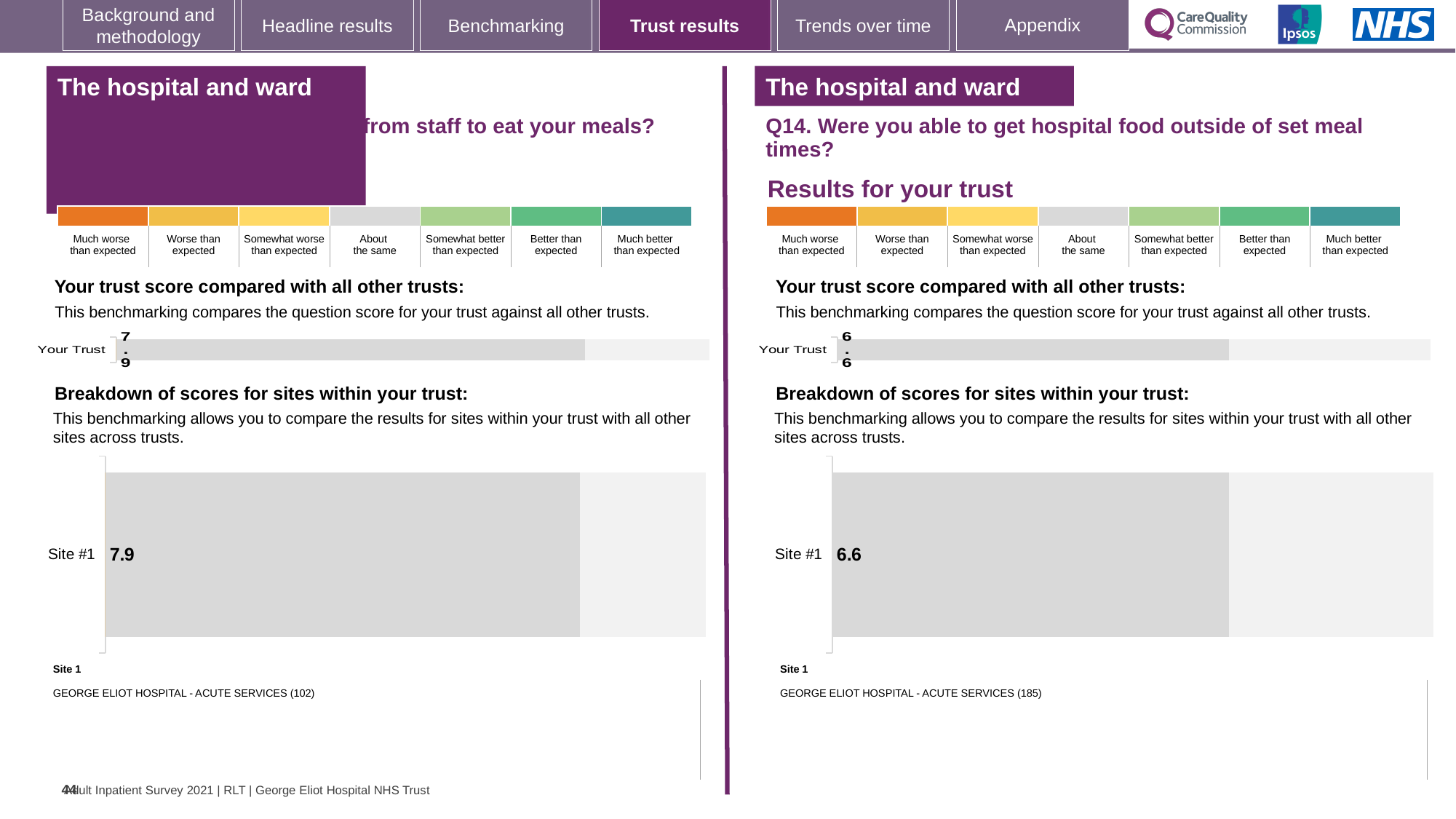
In the right-hand 'Breakdown of scores for sites within your trust' chart for Q14, what is the score for Site #1? 6.6 On the left-hand side of the slide, what is the 'Your Trust' score shown in the 'Your trust score compared with all other trusts' chart? 7.9 What type of chart is used to show the Site #1 score on the right-hand side of the slide? Bar chart What type of chart is used to show the 'Your Trust' score on the left-hand side of the slide? Bar chart How many sites are shown in the left-hand 'Breakdown of scores for sites within your trust' chart? 1 Which is larger: the 'Your Trust' score on the left-hand side of the slide or the 'Your Trust' score on the right-hand side (Q14)? Left-hand side (7.9) On the right-hand side of the slide (Q14), what is the 'Your Trust' score shown in the 'Your trust score compared with all other trusts' chart? 6.6 In the left-hand 'Breakdown of scores for sites within your trust' chart, what is the score for Site #1? 7.9 How many benchmark categories are shown in the colour key above the Q14 chart on the right-hand side of the slide? 7 Which site name is listed as Site 1 below the right-hand breakdown chart for Q14? GEORGE ELIOT HOSPITAL - ACUTE SERVICES (185) How many sites are shown in the right-hand 'Breakdown of scores for sites within your trust' chart for Q14? 1 What is the difference between the Site #1 score on the left-hand side of the slide and the Site #1 score on the right-hand side (Q14)? 1.3